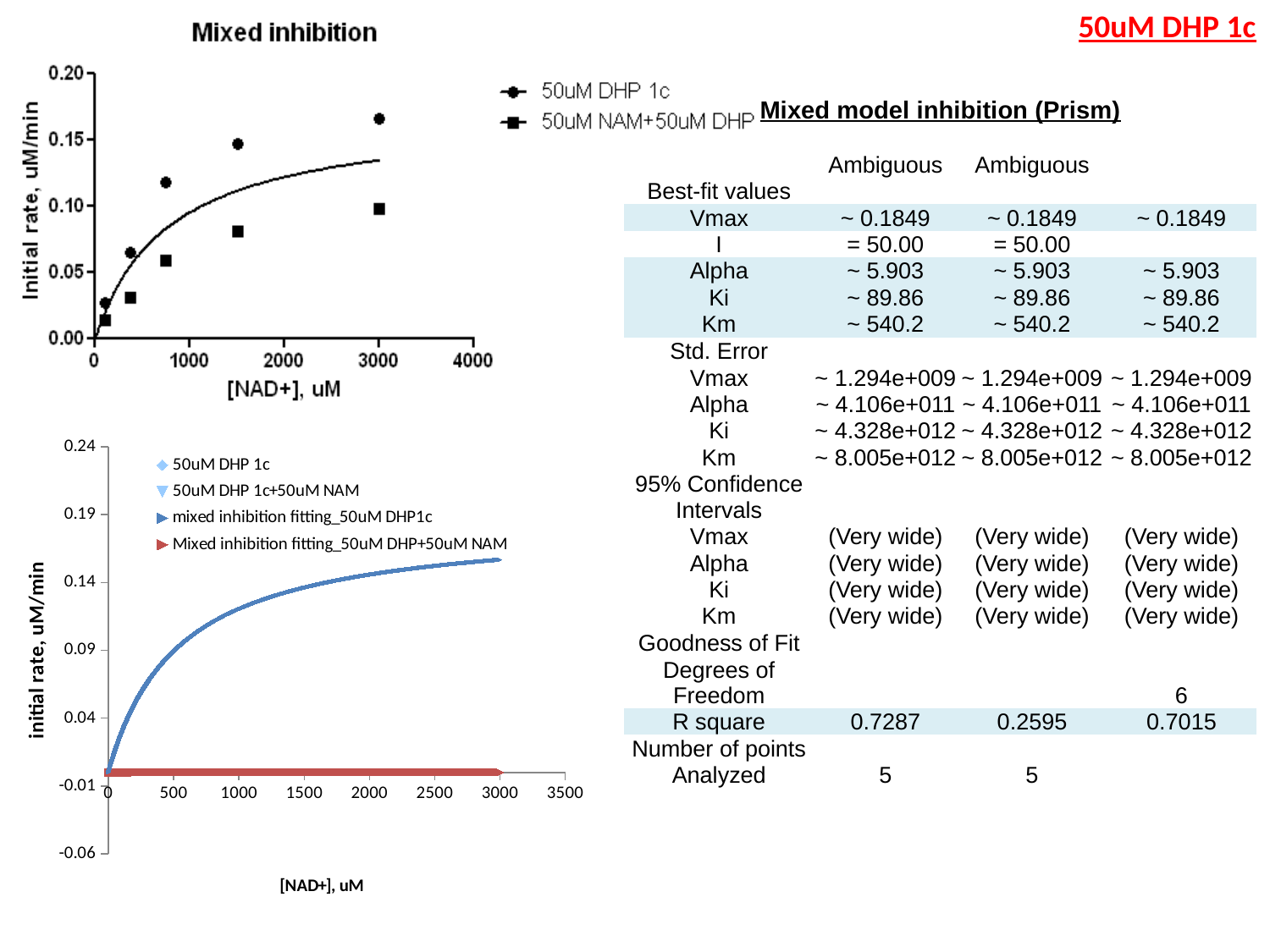
How many series does the legend of the top-left "Mixed inhibition" chart list? 2 What is the x-axis title of the top-left "Mixed inhibition" chart? [NAD+], uM In the top-left "Mixed inhibition" chart, is the initial rate for 50uM NAM+50uM DHP at [NAD+] = 3000 uM greater or less than 0.15? less In the bottom-left chart, is the Mixed inhibition fitting_50uM DHP+50uM NAM line greater or less than 0.04 across the plotted range? less In the bottom-left chart, is the value of the mixed inhibition fitting_50uM DHP1c curve at [NAD+] = 3000 uM greater or less than 0.14? greater In the top-left "Mixed inhibition" chart, which series has the higher initial rate at [NAD+] = 3000 uM, 50uM DHP 1c or 50uM NAM+50uM DHP? 50uM DHP 1c In the bottom-left chart, does the mixed inhibition fitting_50uM DHP1c curve rise or fall as [NAD+] increases? rise What kind of chart is the top-left chart titled "Mixed inhibition"? scatter chart What is the y-axis title of the bottom-left chart? initial rate, uM/min How many entries does the legend of the bottom-left chart list? 4 In the top-left "Mixed inhibition" chart, how many data points are plotted for the 50uM DHP 1c series? 5